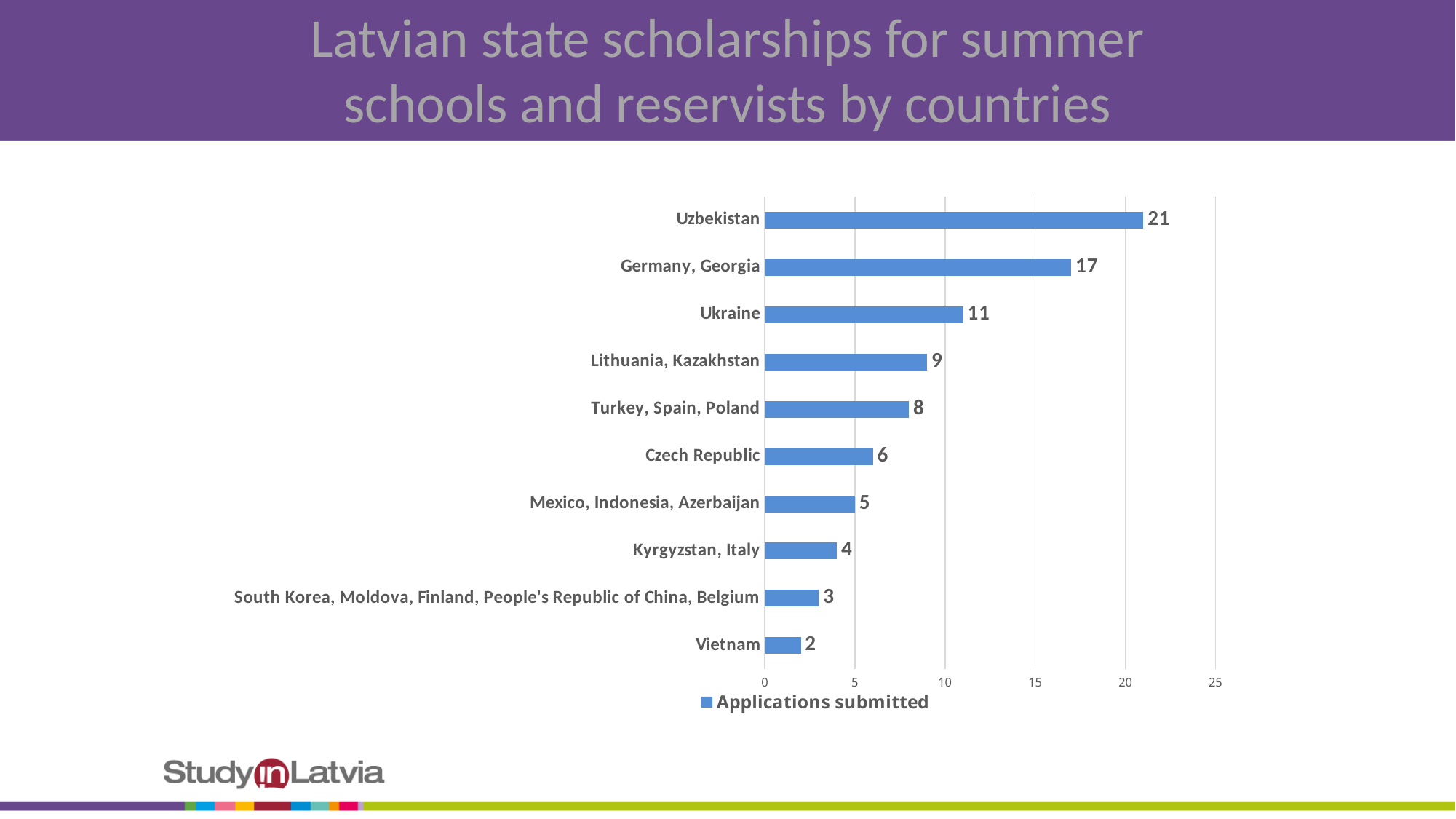
What is the value for Vietnam? 2 Is the value for Germany, Georgia greater or less than 15? greater What kind of chart is shown on the slide? bar chart Which category has the lowest number of applications submitted? Vietnam Which is larger, the value for Lithuania, Kazakhstan or the value for Turkey, Spain, Poland? Lithuania, Kazakhstan How many applications were submitted for Uzbekistan? 21 How many categories are shown on the chart? 10 Which category has the highest number of applications submitted? Uzbekistan What series does the legend list? Applications submitted What is the difference between the values for Uzbekistan and Germany, Georgia? 4 What is the value for Ukraine? 11 How many applications were submitted for Czech Republic? 6